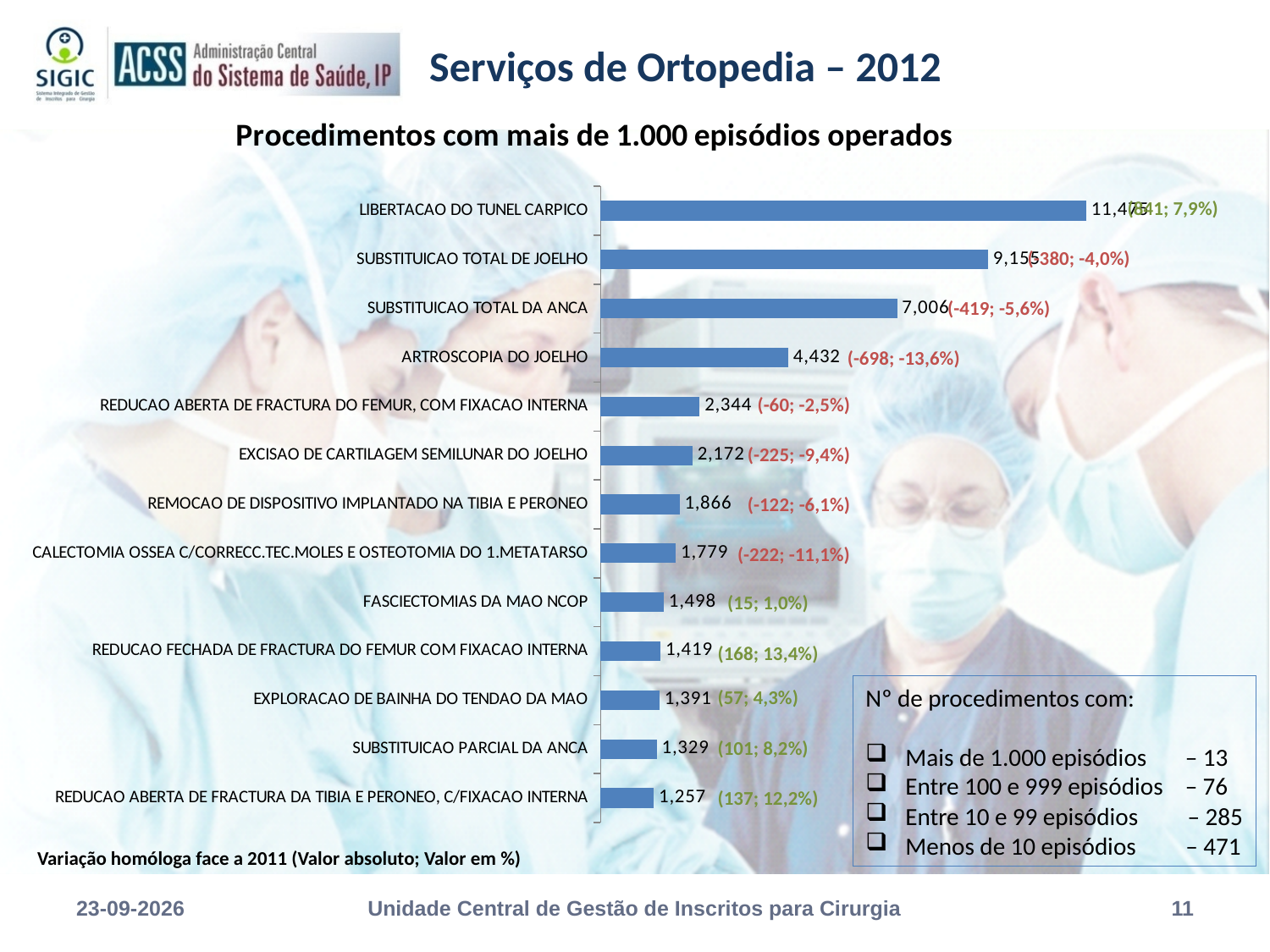
Which procedure has the lowest number of episodes in the chart? REDUCAO ABERTA DE FRACTURA DA TIBIA E PERONEO, C/FIXACAO INTERNA What kind of chart is shown on the slide? bar chart Which has a larger value: EXCISAO DE CARTILAGEM SEMILUNAR DO JOELHO or REMOCAO DE DISPOSITIVO IMPLANTADO NA TIBIA E PERONEO? EXCISAO DE CARTILAGEM SEMILUNAR DO JOELHO Which procedure has the highest number of episodes in the chart? LIBERTACAO DO TUNEL CARPICO What homologous variation versus 2011 is printed next to the bar for ARTROSCOPIA DO JOELHO? (-698; -13,6%) What is the value shown for FASCIECTOMIAS DA MAO NCOP? 1,498 What is the title of the chart? Procedimentos com mais de 1.000 episódios operados How many procedures (categories) are plotted in the chart? 13 What is the value shown for SUBSTITUICAO PARCIAL DA ANCA? 1,329 What is the value shown for SUBSTITUICAO TOTAL DA ANCA? 7,006 What is the value shown for ARTROSCOPIA DO JOELHO? 4,432 What is the difference between the values for SUBSTITUICAO TOTAL DA ANCA and ARTROSCOPIA DO JOELHO? 2,574